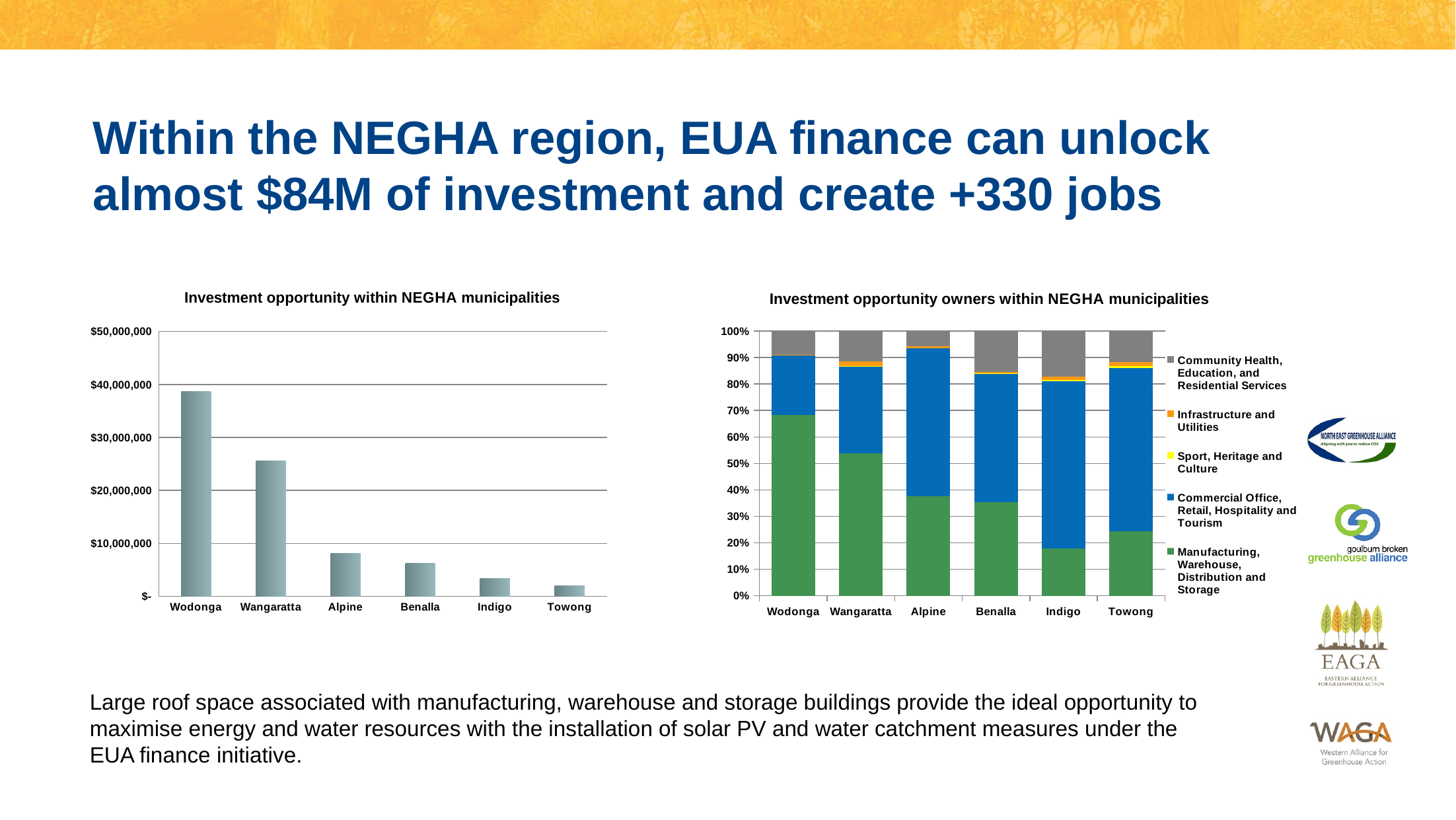
How many series does the legend of the 'Investment opportunity owners within NEGHA municipalities' chart list? 5 In the 'Investment opportunity within NEGHA municipalities' chart, do the values rise or fall moving from Wodonga to Towong along the x axis? Fall What kind of chart is 'Investment opportunity within NEGHA municipalities'? Bar chart In the 'Investment opportunity within NEGHA municipalities' chart, how many municipalities are shown on the x axis? 6 In the 'Investment opportunity within NEGHA municipalities' chart, is the value for Alpine greater or less than $10,000,000? less In the 'Investment opportunity owners within NEGHA municipalities' chart, which municipality has the largest share for Manufacturing, Warehouse, Distribution and Storage? Wodonga In the 'Investment opportunity within NEGHA municipalities' chart, which municipality has the lowest investment opportunity? Towong In the 'Investment opportunity owners within NEGHA municipalities' chart, is the Manufacturing, Warehouse, Distribution and Storage share for Wodonga greater or less than 60%? greater In the 'Investment opportunity owners within NEGHA municipalities' chart, which colour represents Commercial Office, Retail, Hospitality and Tourism? Blue In the 'Investment opportunity owners within NEGHA municipalities' chart, which municipality has the smallest share for Manufacturing, Warehouse, Distribution and Storage? Indigo In the 'Investment opportunity within NEGHA municipalities' chart, is the value for Wodonga greater or less than $30,000,000? greater In the 'Investment opportunity within NEGHA municipalities' chart, which municipality has the highest investment opportunity? Wodonga